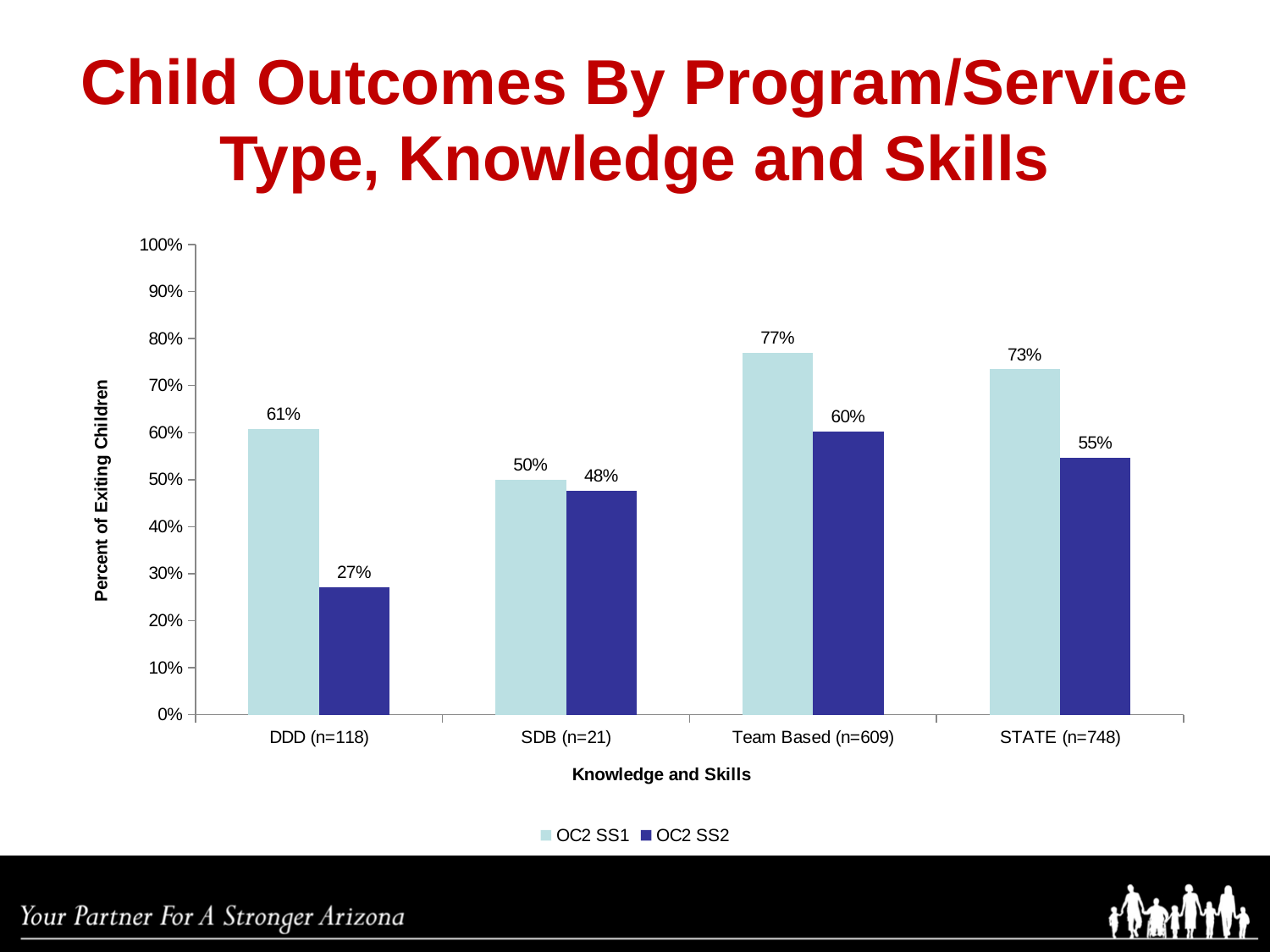
Is the OC2 SS2 value for Team Based (n=609) greater or less than 50%? greater Which is larger for SDB (n=21): the OC2 SS1 value or the OC2 SS2 value? OC2 SS1 What is the difference between the OC2 SS1 and OC2 SS2 values for DDD (n=118)? 34% What is the OC2 SS2 value for DDD (n=118)? 27% What kind of chart is shown on the slide? bar chart Which category has the highest OC2 SS1 value? Team Based (n=609) How many categories are shown on the x axis? 4 How many series does the legend list? 2 Which category has the lowest OC2 SS2 value? DDD (n=118) What is the label of the y axis? Percent of Exiting Children What is the OC2 SS2 value for STATE (n=748)? 55% What is the OC2 SS1 value for Team Based (n=609)? 77%